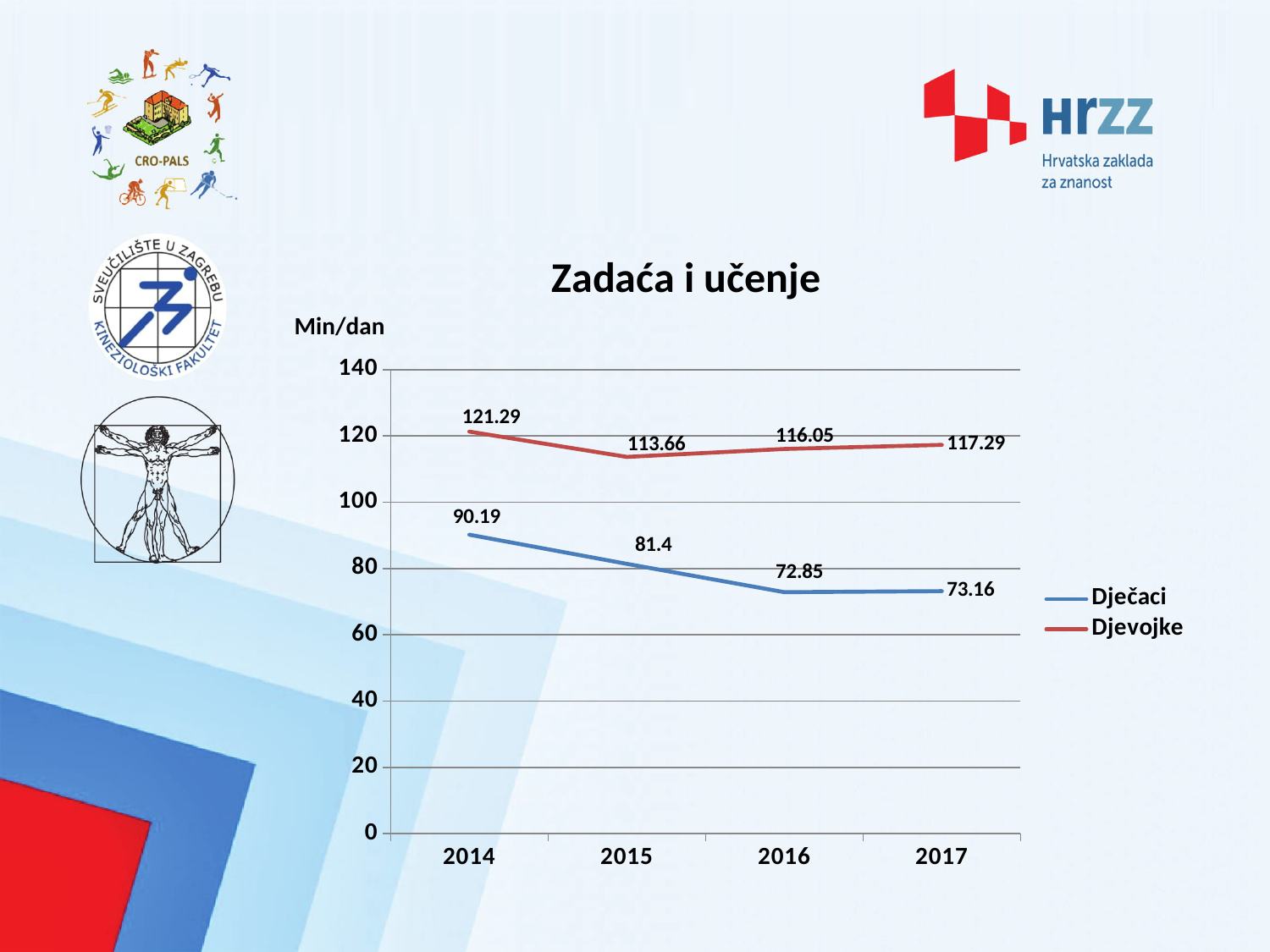
How many series does the legend list? 2 What is the title of the chart? Zadaća i učenje What is the value for Djevojke in 2017? 117.29 What is the value for Dječaci in 2014? 90.19 What is the value for Djevojke in 2015? 113.66 In which year is the Djevojke value highest? 2014 What is the difference between the Djevojke and Dječaci values in 2016? 43.2 Which series has the larger value in 2015, Dječaci or Djevojke? Djevojke In which year is the Dječaci value lowest? 2016 What kind of chart is shown? line chart Is the value for Dječaci in 2017 greater or less than 80? less How many years are shown on the x axis? 4